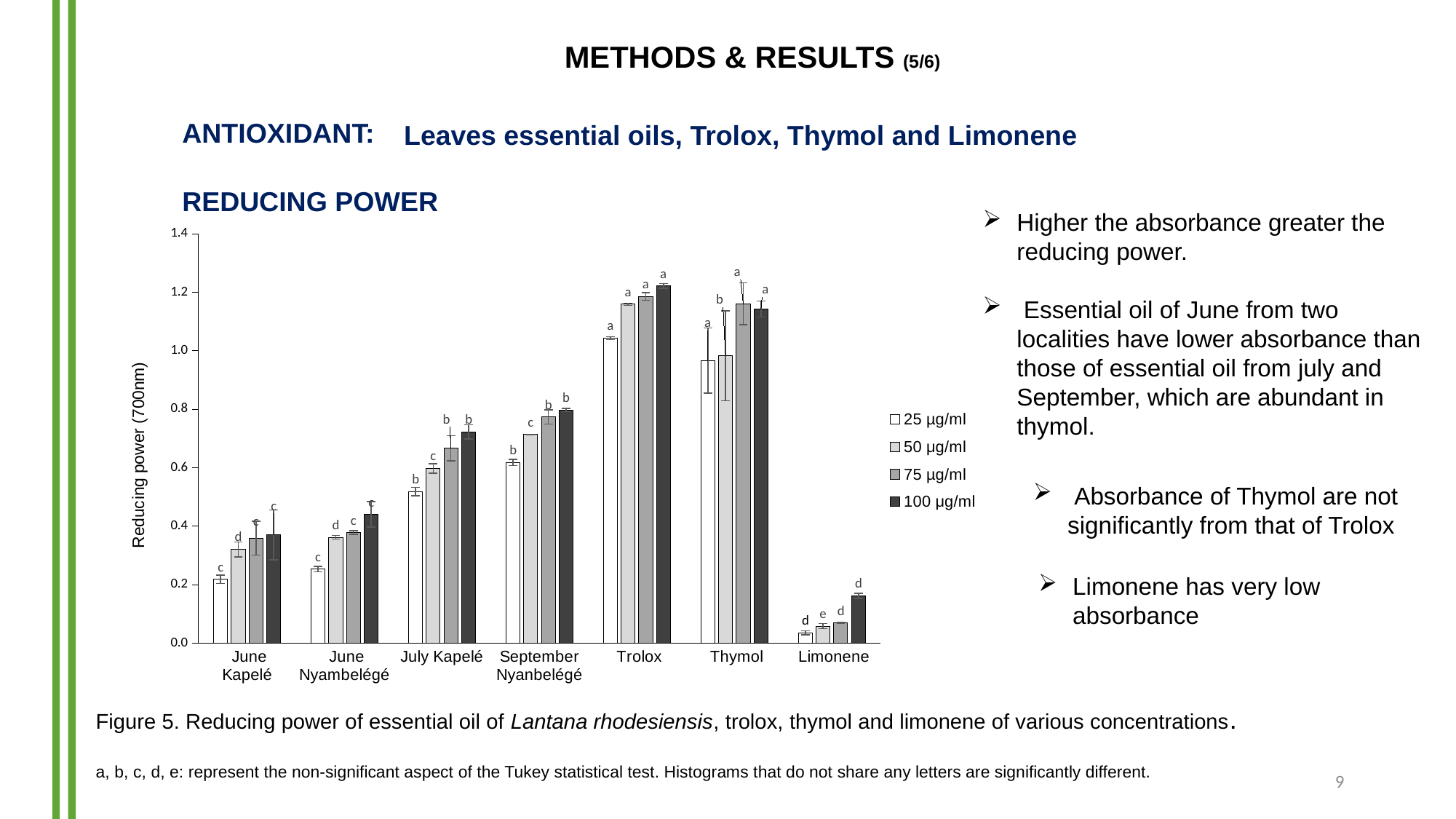
Is the value for July Kapelé at 100 µg/ml greater or less than 0.6? greater Which category has the lowest bar for the 25 µg/ml series? Limonene Which category has the highest bar for the 100 µg/ml series? Trolox Is the value for June Kapelé at 25 µg/ml greater or less than 0.4? less How many categories are shown along the x axis of the chart? 7 Which is larger at 100 µg/ml: July Kapelé or September Nyanbelégé? September Nyanbelégé Which is larger at 25 µg/ml: Trolox or Thymol? Trolox How many series does the chart's legend list? 4 Is the value for Trolox at 25 µg/ml greater or less than 1.0? greater What kind of chart is shown on the slide? Bar chart What is the label of the chart's y axis? Reducing power (700nm)